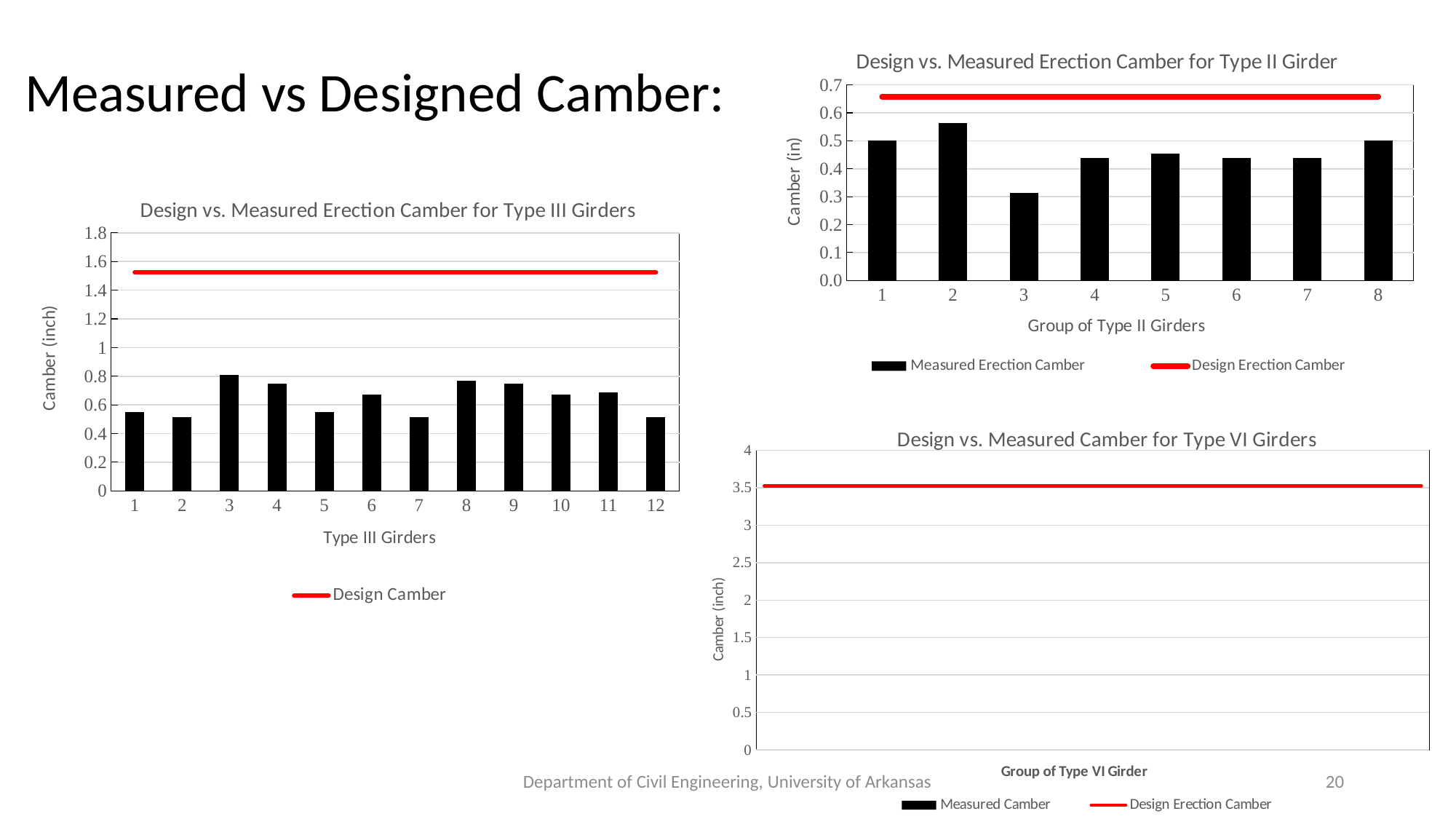
In the chart titled "Design vs. Measured Erection Camber for Type II Girder", is the measured erection camber for group 2 greater or less than 0.5? greater In the chart titled "Design vs. Measured Erection Camber for Type III Girders", is the measured camber for girder 6 greater or less than 0.6? greater In the chart titled "Design vs. Measured Erection Camber for Type III Girders", is the design camber line greater or less than 1.4? greater In the chart titled "Design vs. Measured Erection Camber for Type II Girder", which group has the highest measured erection camber? 2 How many series does the legend list in the chart titled "Design vs. Measured Erection Camber for Type II Girder"? 2 How many Type III girders are shown on the x axis of the chart titled "Design vs. Measured Erection Camber for Type III Girders"? 12 What kind of chart is the one titled "Design vs. Measured Erection Camber for Type III Girders"? combination bar and line chart How many groups of Type II girders are shown on the x axis of the chart titled "Design vs. Measured Erection Camber for Type II Girder"? 8 In the chart titled "Design vs. Measured Erection Camber for Type II Girder", which group has the lowest measured erection camber? 3 In the chart titled "Design vs. Measured Erection Camber for Type II Girder", which has the larger measured erection camber, group 1 or group 3? group 1